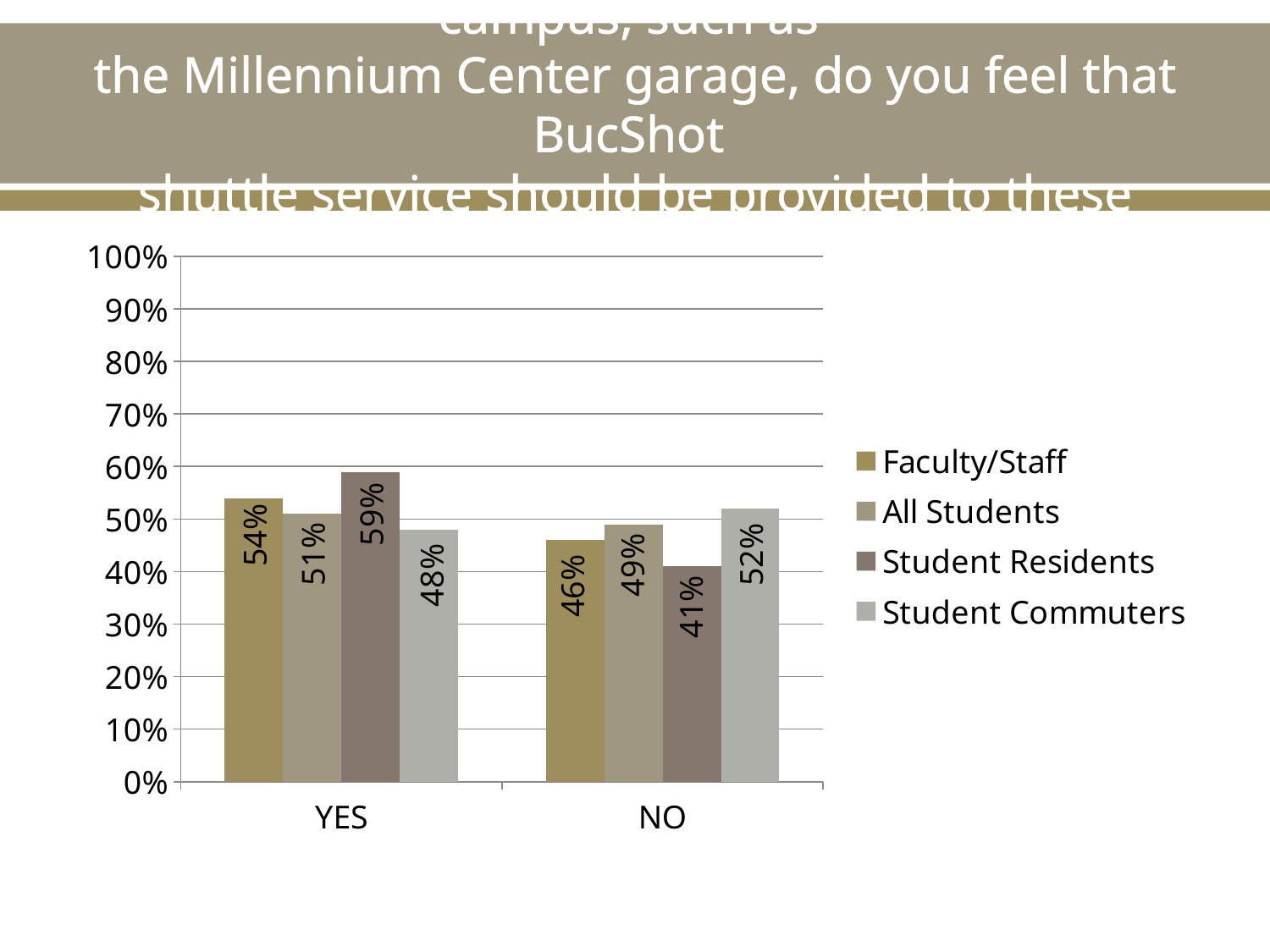
What kind of chart is shown on the slide? Bar chart What is the difference between the YES and NO values for Student Residents? 18% Which legend entry is shown in the lightest grey colour? Student Commuters How many categories are shown on the x axis? 2 What percentage of Faculty/Staff answered NO? 46% Which is larger: the YES value for All Students or the YES value for Student Commuters? All Students How many series does the legend list? 4 Which group has the highest value in the YES category? Student Residents Which group has the lowest value in the NO category? Student Residents What percentage of Student Residents answered YES? 59% What is the difference between the Faculty/Staff YES value and the Faculty/Staff NO value? 8% What is the value for Student Commuters in the NO category? 52%